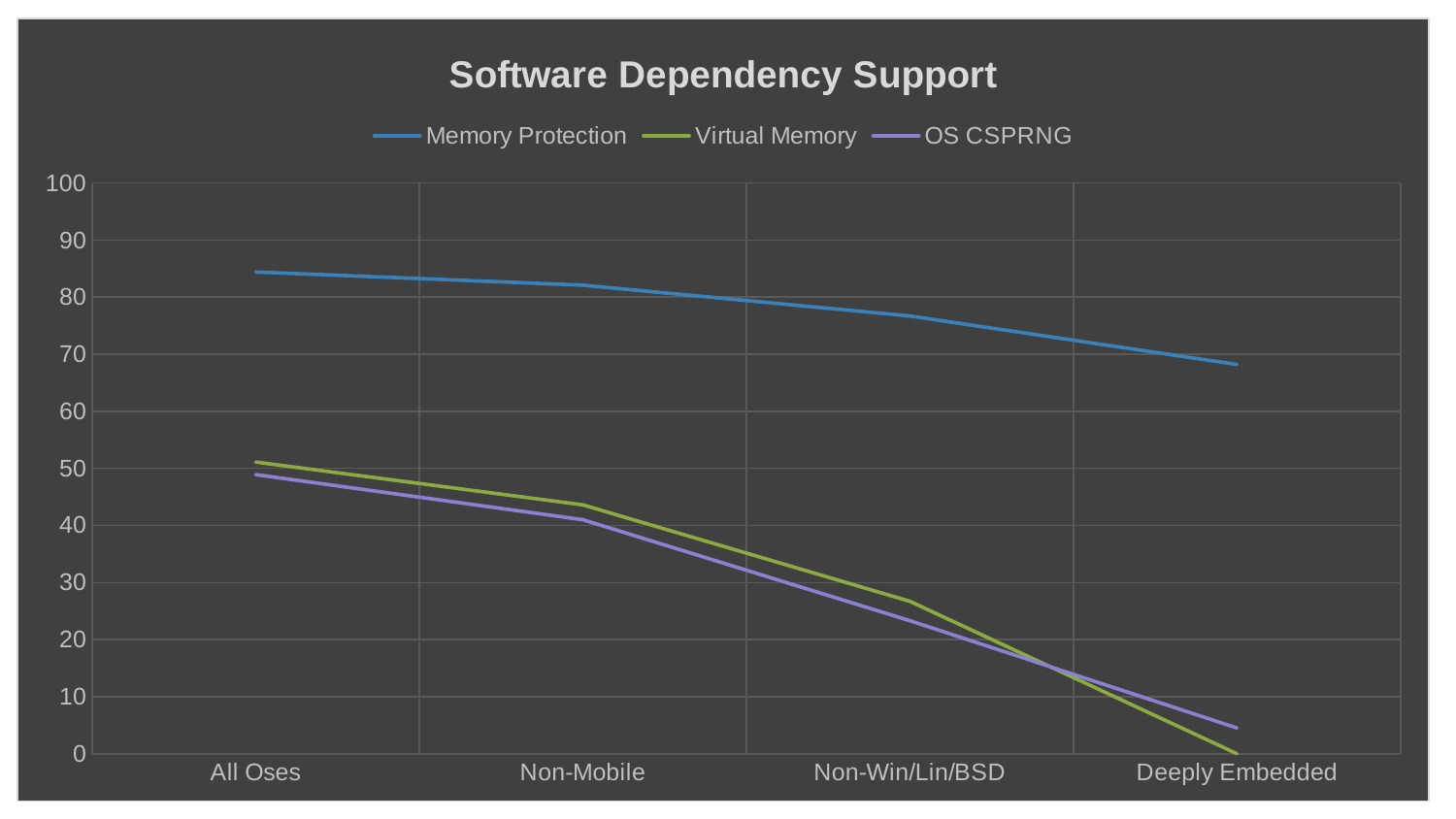
Is the value for OS CSPRNG at Non-Win/Lin/BSD greater or less than 30? less At Non-Mobile, which is larger: Virtual Memory or OS CSPRNG? Virtual Memory Is the value for Memory Protection at All Oses greater or less than 80? greater What is the title of the chart? Software Dependency Support Do the Memory Protection values rise or fall from All Oses to Deeply Embedded? fall Which series has the highest value at Non-Win/Lin/BSD? Memory Protection Which series has the lowest value at Deeply Embedded? Virtual Memory How many series does the legend list? 3 Which series is plotted with the blue line? Memory Protection Is the value for Virtual Memory at Non-Mobile greater or less than 50? less How many categories are shown on the x axis? 4 What kind of chart is shown on the slide? line chart